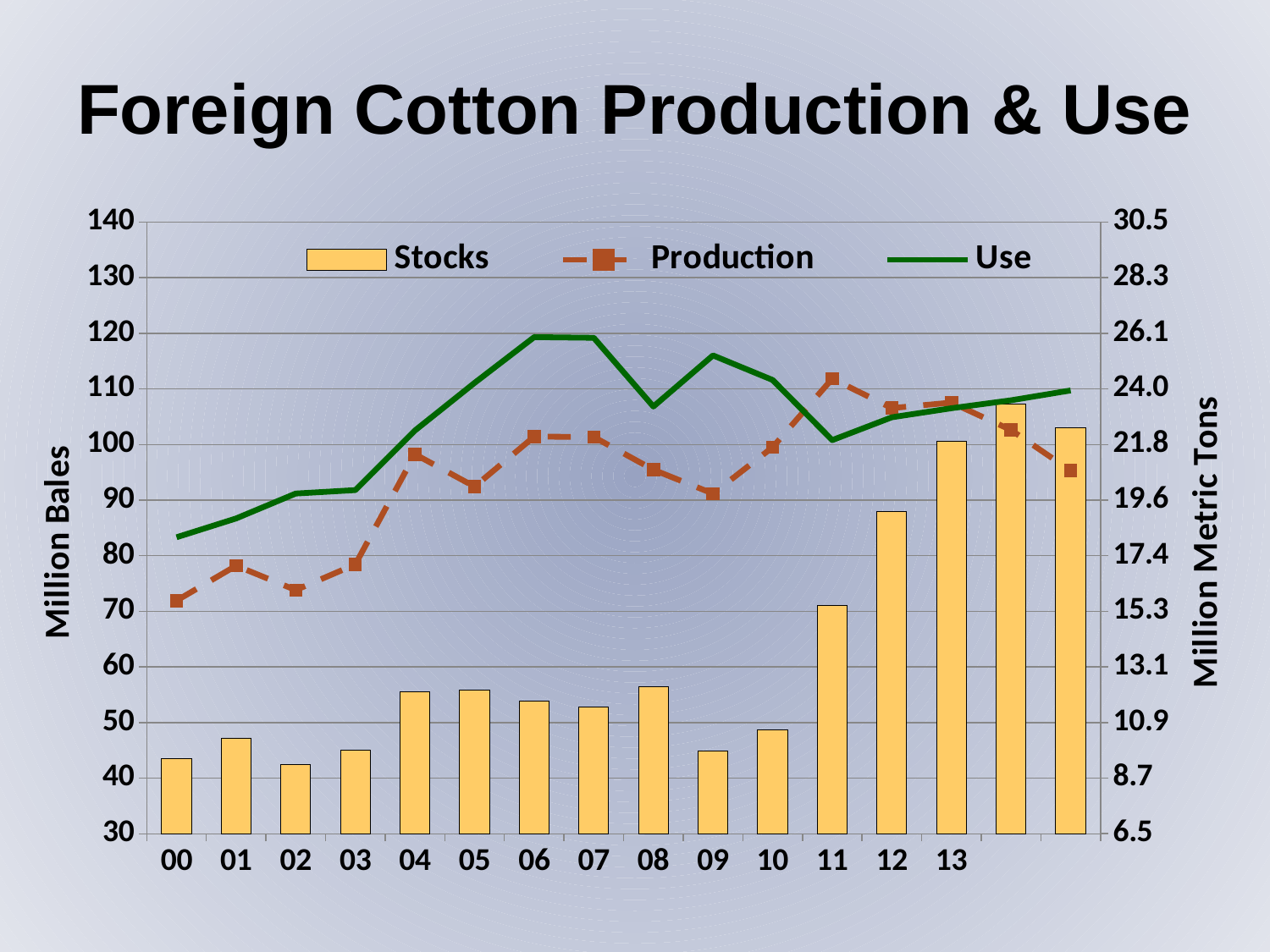
Is the Stocks value for 12 greater or less than 80 million bales? greater What kind of chart is shown on the slide? A combined bar and line chart In which year does the Production line reach its highest point? 11 Which is larger in 06, Use or Production? Use Which year from 00 to 13 has the highest Stocks bar? 13 In which year is the Use line at its lowest? 00 Do the Stocks bars rise or fall from 10 to 13? Rise Which series is drawn as bars? Stocks What is the label of the left vertical axis? Million Bales Is the Use value for 06 greater or less than 24.0 million metric tons? greater Is the Stocks value for 00 greater or less than 50 million bales? less How many series does the legend list? 3